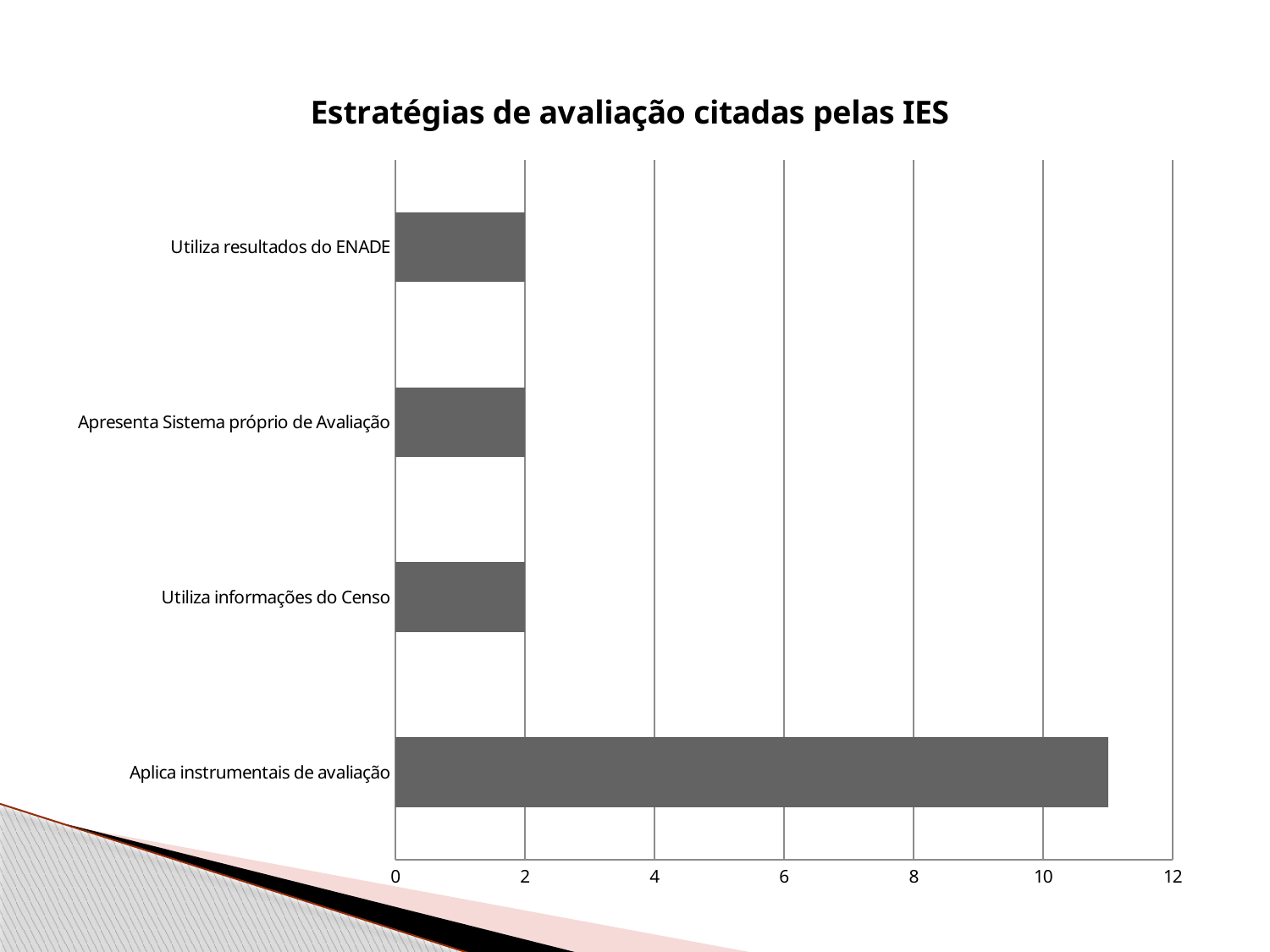
What is the value for Apresenta Sistema próprio de Avaliação? 2 What kind of chart is shown on the slide? bar chart What is the value for Utiliza informações do Censo? 2 Which is larger, the value for Aplica instrumentais de avaliação or the value for Utiliza informações do Censo? Aplica instrumentais de avaliação How many categories are shown in the chart? 4 What is the maximum value shown on the horizontal axis? 12 What is the title of the chart? Estratégias de avaliação citadas pelas IES Is the value for Aplica instrumentais de avaliação greater or less than 10? greater Is the value for Aplica instrumentais de avaliação greater or less than 12? less Which category has the highest value? Aplica instrumentais de avaliação What is the value for Utiliza resultados do ENADE? 2